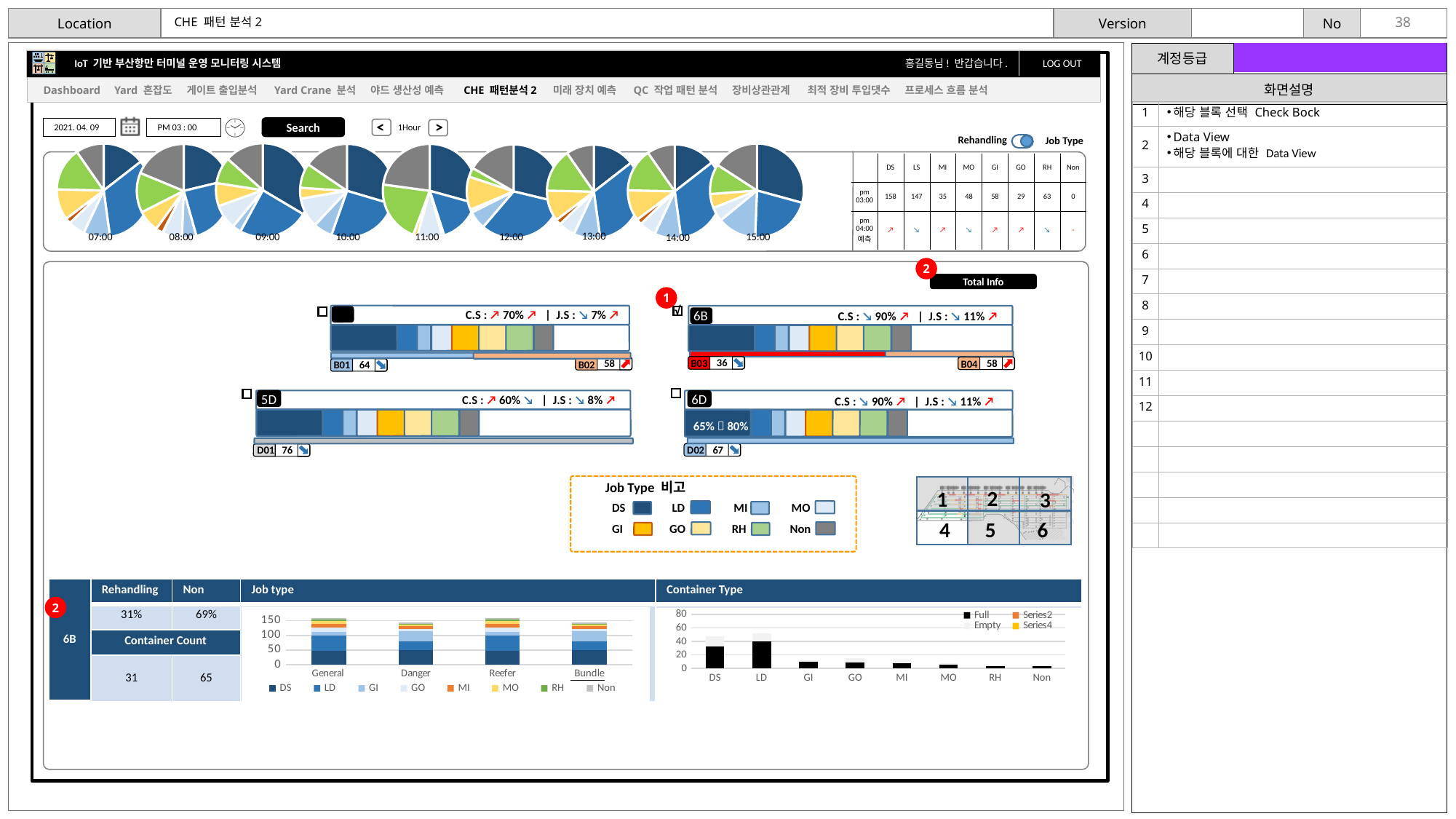
What kind of chart is the 'Job type' chart at the bottom of the slide? bar chart In the 'Container Type' chart, is the Full value for DS greater or less than 40? less What kind of chart is the 'Container Type' chart at the bottom right? bar chart In the 'Container Type' chart, which category has the highest bar? LD In the 'Container Type' chart, which is larger, the bar for DS or the bar for GI? DS How many entries does the legend of the 'Container Type' chart list? 4 How many series does the legend of the 'Job type' chart list? 8 How many pie charts are shown in the row of hourly pie charts at the top of the dashboard? 9 In the block bar labelled 5D, what is the C.S value shown? 60% How many categories are shown on the x axis of the 'Job type' chart? 4 In the 'Job type' chart, is the total stacked value for General greater or less than 100? greater How many categories are shown on the x axis of the 'Container Type' chart? 8